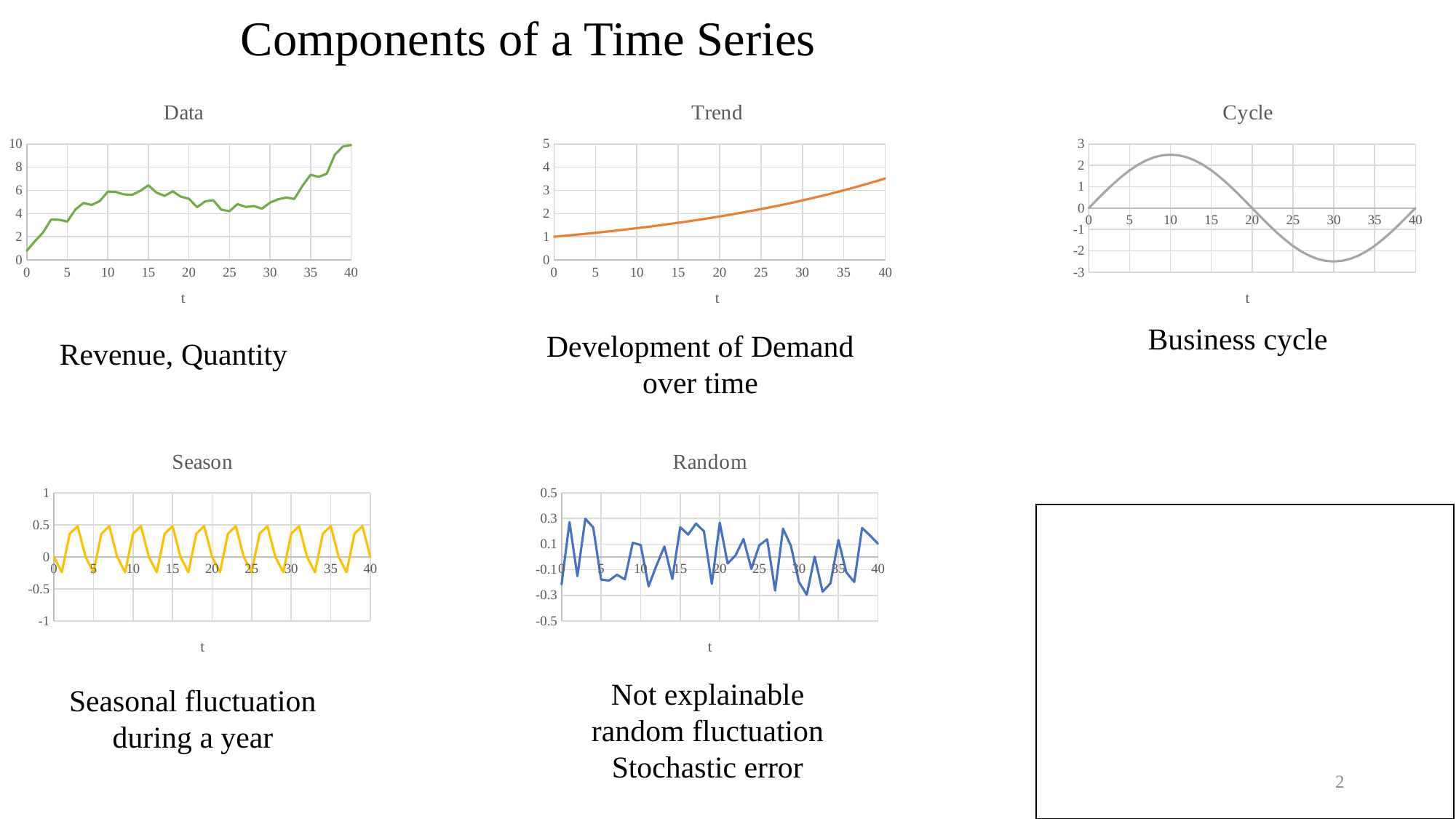
In the "Season" chart, is the highest value reached greater or less than 1? less In the "Trend" chart, what is the value at t = 0? 1 In the "Cycle" chart, is the value at t = 30 greater or less than -2? less In the "Cycle" chart, is the value at t = 10 greater or less than 2? greater What kind of chart is the "Data" chart? line chart What is the title of the chart in the top-right position of the slide? Cycle In the "Trend" chart, do the values rise or fall as t increases from 0 to 40? rise In the "Cycle" chart, what is the value at t = 20? 0 How many charts are shown on the slide? 5